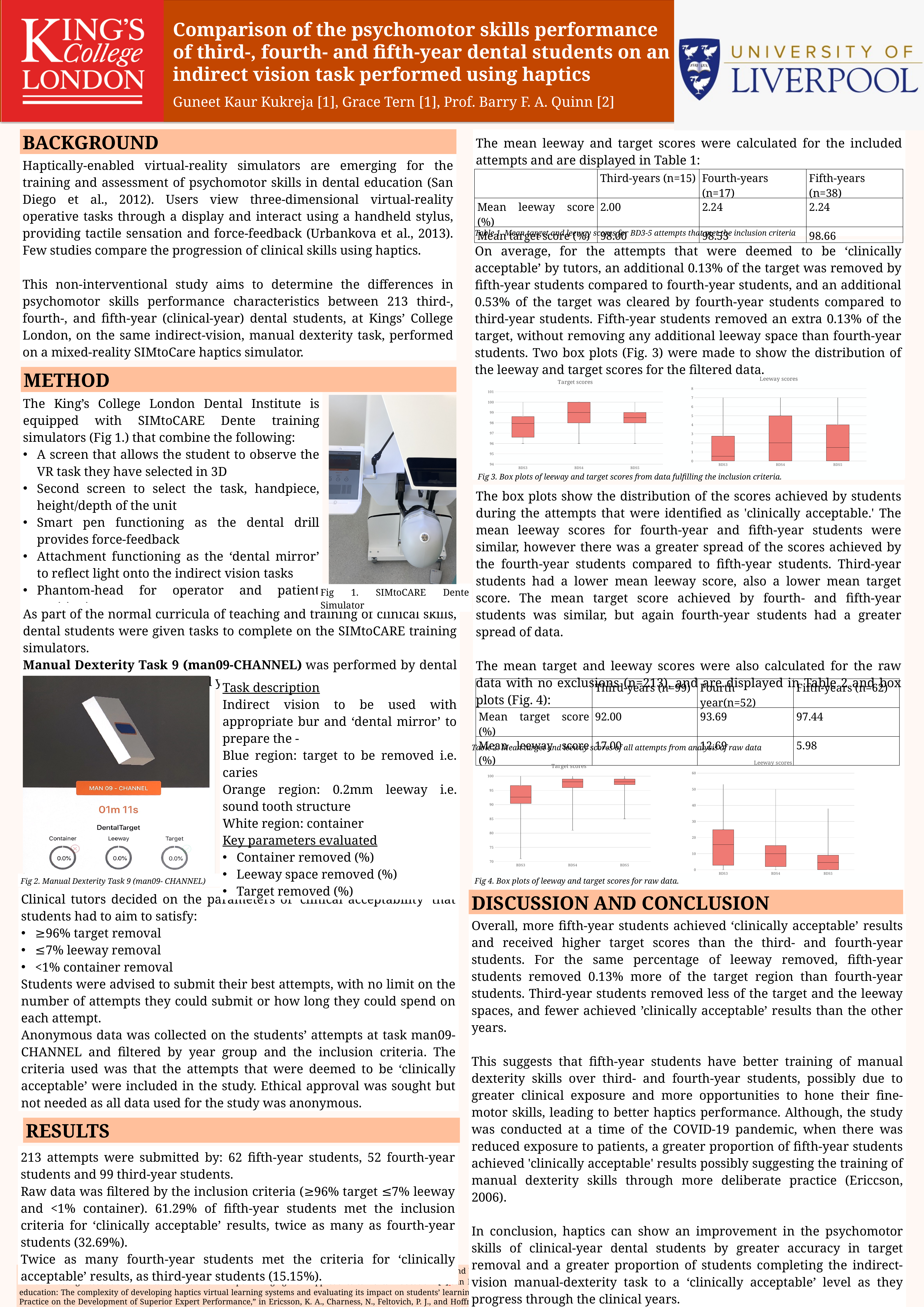
In the Fig 3 'Leeway scores' box plot, is the median for BDS3 greater or less than 2? less In the Fig 4 'Leeway scores' box plot, which category has the lowest median leeway score? BDS5 In Fig 3, what kind of chart is used to show the target scores and leeway scores? Box plot In the Fig 4 'Target scores' box plot, which category has the lowest median target score? BDS3 In the Fig 3 'Leeway scores' box plot, what are the three category labels on the x axis? BDS3, BDS4, BDS5 In the Fig 4 'Target scores' box plot, is the median for BDS5 greater or less than 95? greater In the Fig 4 'Leeway scores' box plot, which category has the highest median leeway score? BDS3 In the Fig 3 'Target scores' box plot, is the median for BDS4 greater or less than 98? greater In the Fig 3 'Target scores' box plot, how many categories are shown on the x axis? 3 In the Fig 3 'Leeway scores' box plot, which category has the highest median leeway score? BDS4